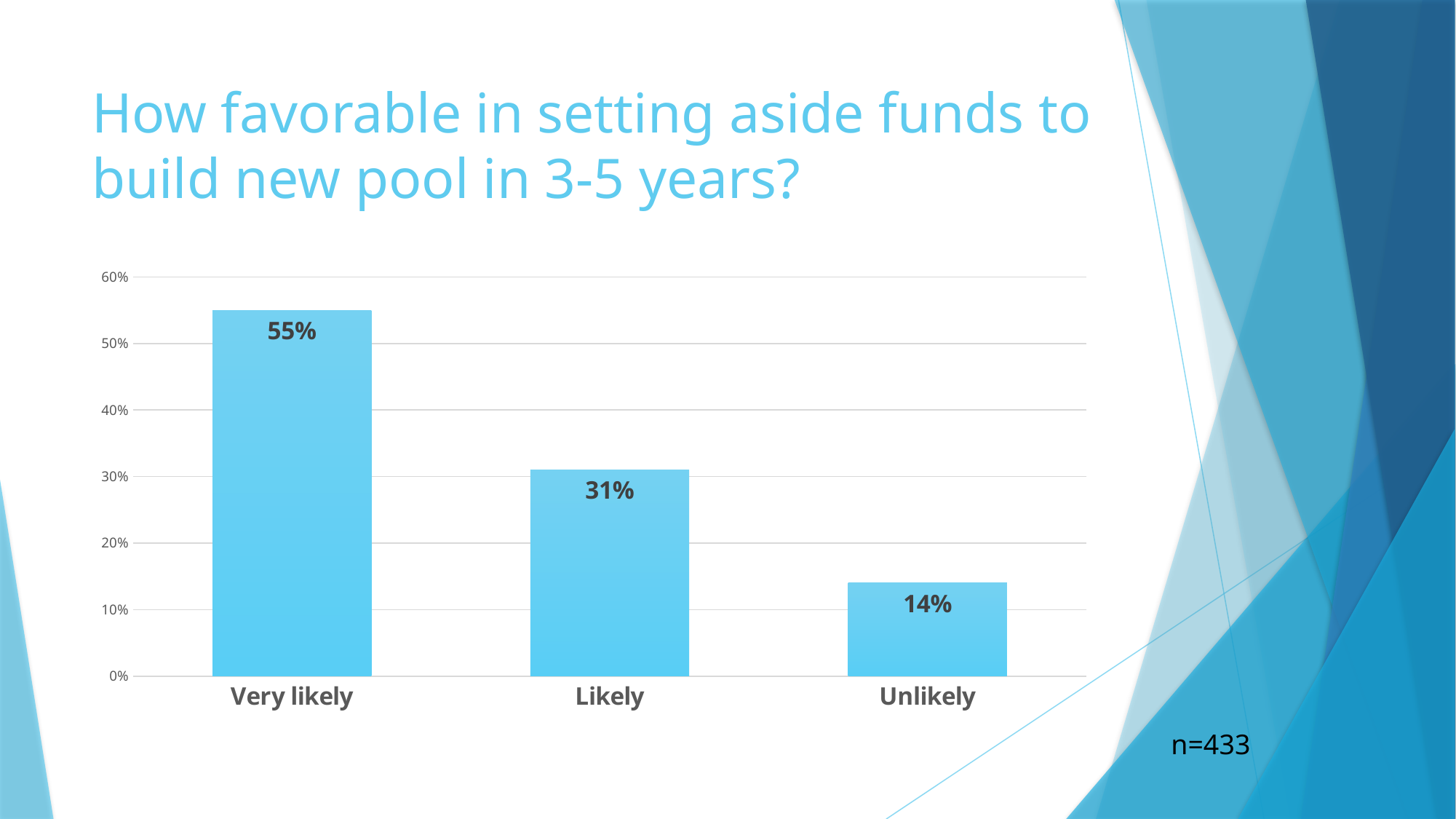
Do the values rise or fall from left to right along the x axis? Fall Is the value for "Very likely" greater or less than 50%? greater What is the value shown for the "Likely" category? 31% What kind of chart is shown on the slide? Bar chart Which is larger, the value for "Likely" or the value for "Unlikely"? Likely What percentage of respondents answered "Very likely"? 55% Which category has the lowest value? Unlikely Which category has the highest value? Very likely What is the difference between the "Very likely" and "Likely" values? 24% What is the value shown for the "Unlikely" category? 14% What is the difference between the "Likely" and "Unlikely" values? 17% How many categories are shown on the x axis? 3